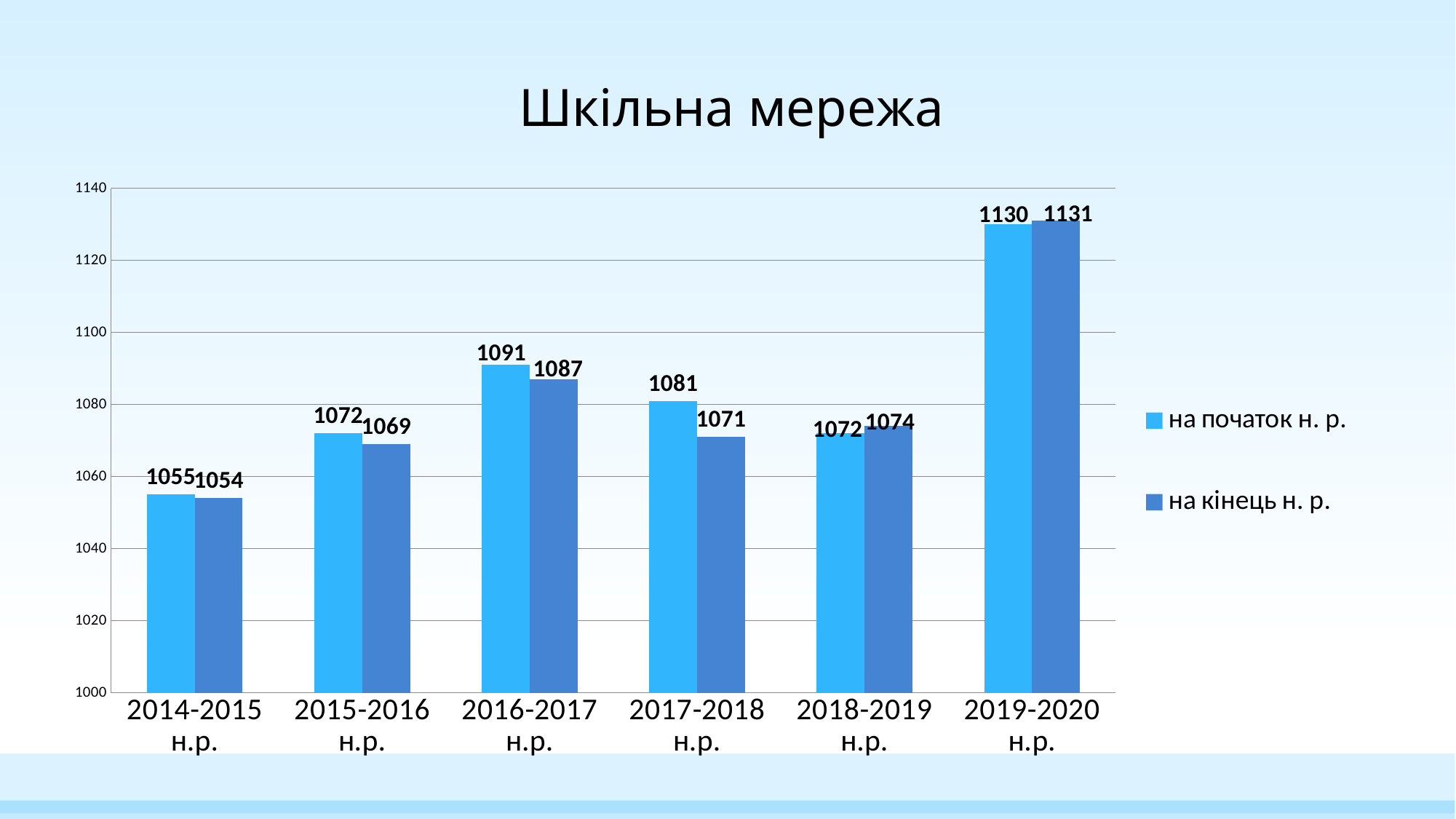
Which school year has the highest value for "на початок н. р."? 2019-2020 н.р. What is the value for "на кінець н. р." in 2017-2018 н.р.? 1071 What is the value for "на кінець н. р." in 2019-2020 н.р.? 1131 What is the value for "на початок н. р." in 2014-2015 н.р.? 1055 Which school year has the lowest value for "на кінець н. р."? 2014-2015 н.р. Is the value for "на початок н. р." in 2019-2020 н.р. greater or less than 1120? greater What kind of chart is shown on the slide? bar chart What is the title of the chart? Шкільна мережа What is the difference between "на початок н. р." and "на кінець н. р." in 2017-2018 н.р.? 10 How many series does the legend list? 2 Which is larger in 2016-2017 н.р.: "на початок н. р." or "на кінець н. р."? на початок н. р. How many school years are shown on the x axis? 6